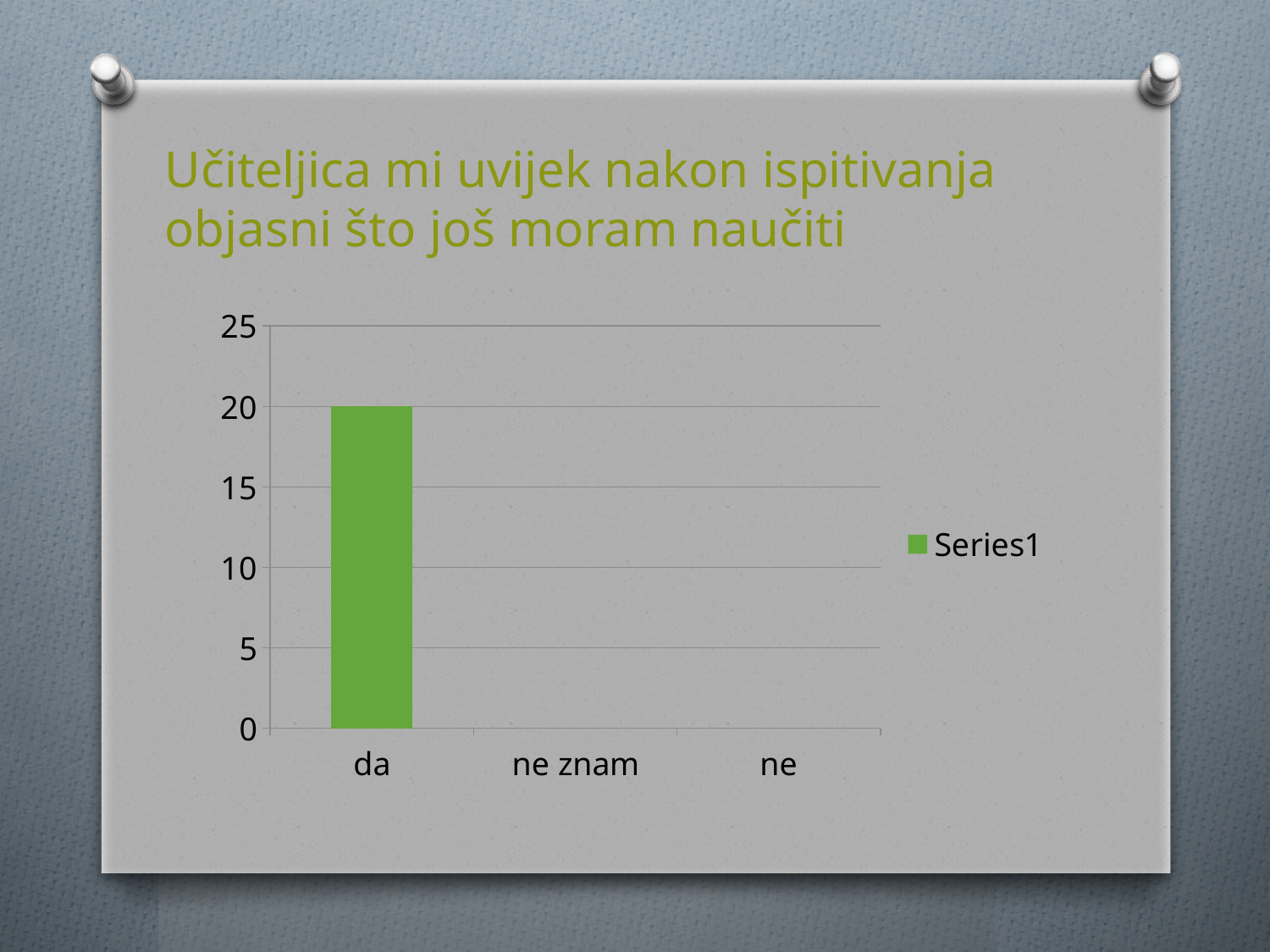
Which is larger, the value for "da" or the value for "ne"? da What is the value for "da"? 20 How many series does the legend list? 1 What kind of chart is shown on the slide? bar chart Is the value for "da" greater or less than 15? greater What is the name of the series shown in the legend? Series1 What is the difference between the value for "da" and the value for "ne znam"? 20 Which category has the highest value? da What is the value for "ne znam"? 0 How many categories are shown on the x axis? 3 Is the value for "da" greater or less than 25? less What is the value for "ne"? 0